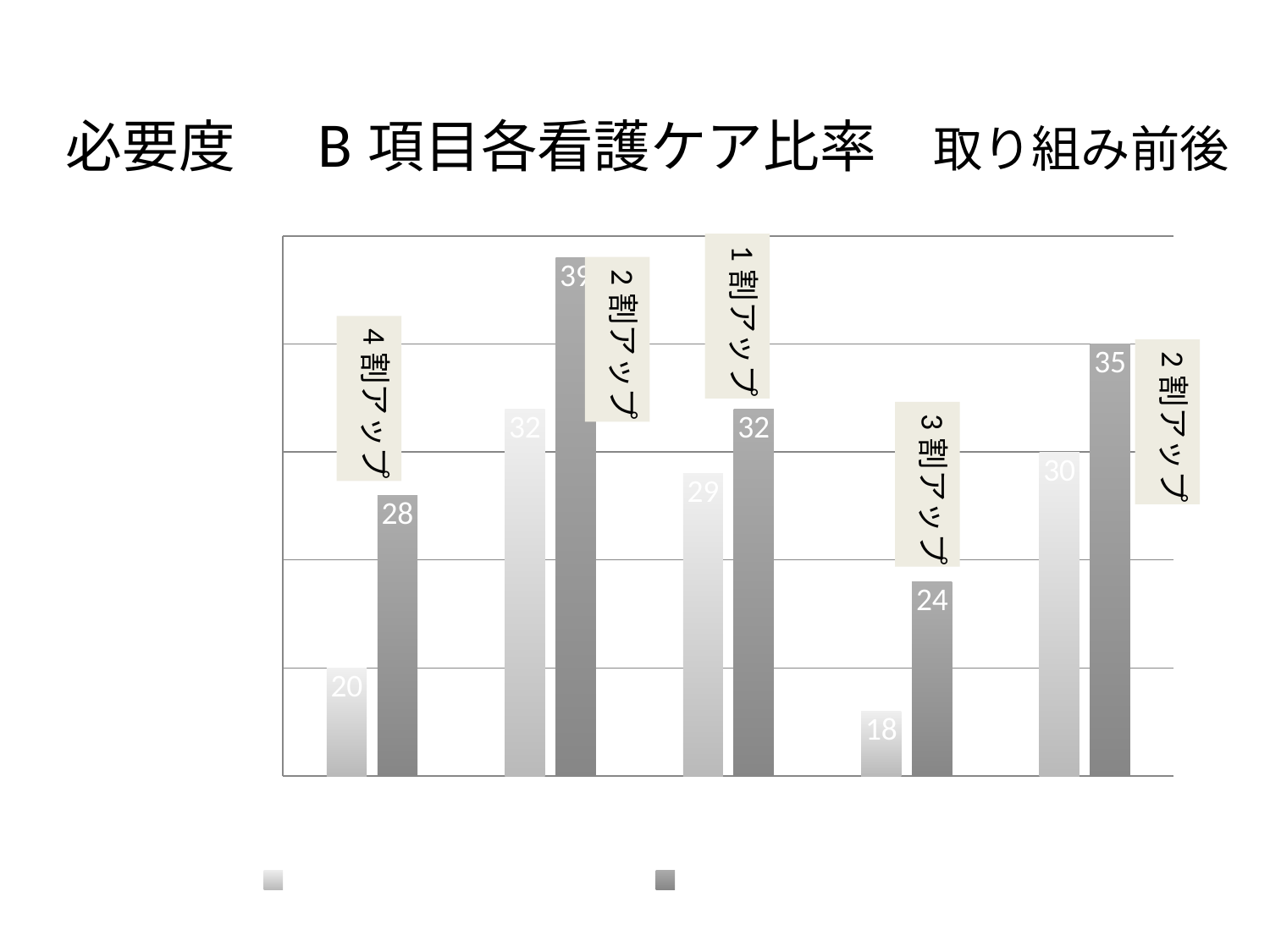
How many series does the legend below the chart list? 2 In the fifth (rightmost) group, what is the difference between the dark grey bar (35) and the light grey bar (30)? 5 What is the highest value shown on any bar in the chart? 39 What is the value of the dark grey bar in the fourth group from the left? 24 What is the value of the dark grey bar in the first (leftmost) group? 28 What does the annotation label above the first (leftmost) group of bars say? 4割アップ In the first (leftmost) group, what is the difference between the dark grey bar and the light grey bar? 8 What kind of chart is shown on the slide? bar chart In the third group from the left, which bar is larger, the light grey bar or the dark grey bar? the dark grey bar What is the value of the light grey bar in the second group from the left? 32 How many groups of bars are plotted in the chart? 5 What is the lowest value shown on any bar in the chart? 18